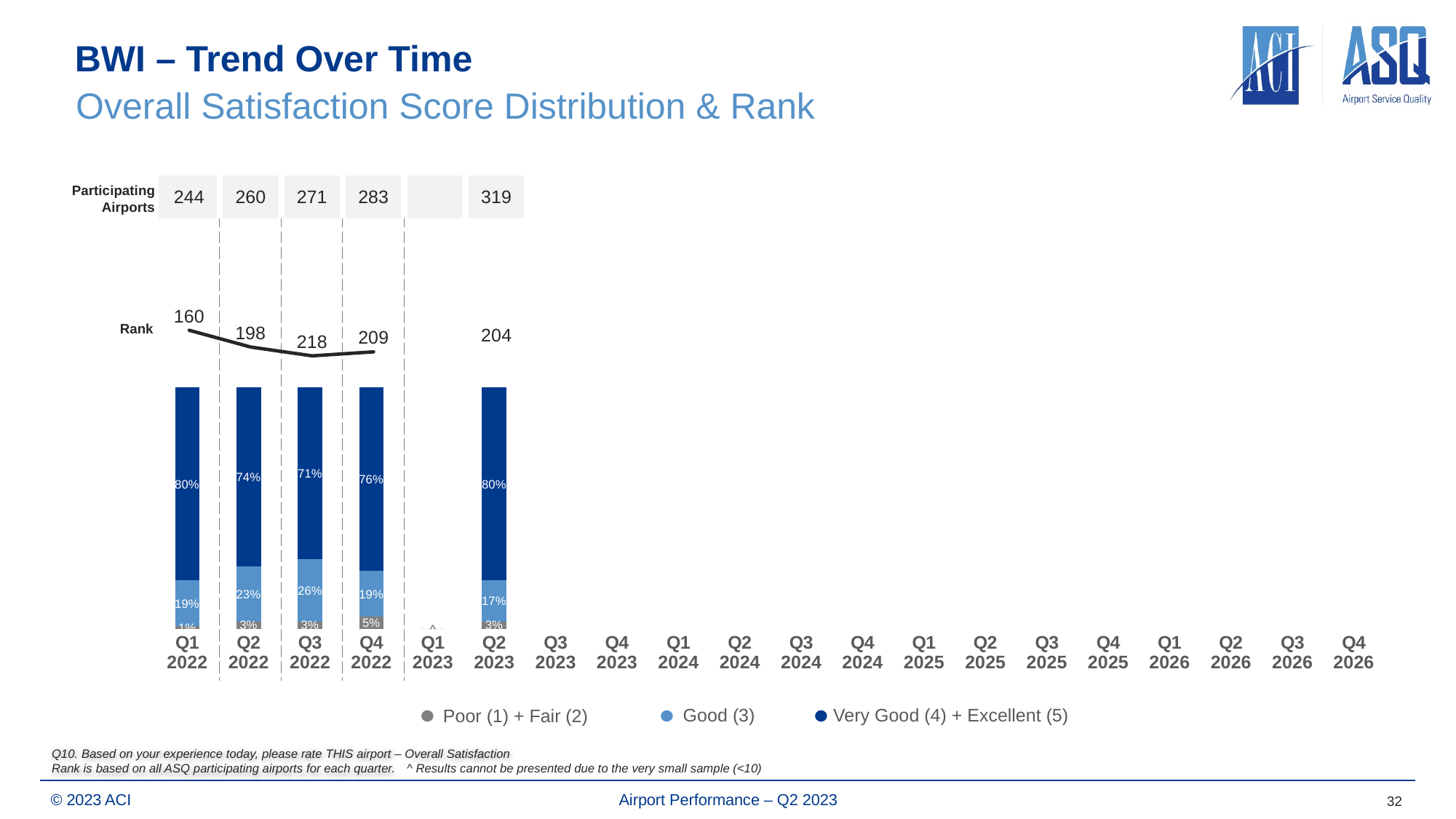
What share of respondents rated BWI Good (3) in Q4 2022? 19% Which quarter had a larger Poor (1) + Fair (2) share, Q4 2022 or Q2 2023? Q4 2022 Why is no bar shown for Q1 2023? Results cannot be presented due to the very small sample (<10) What was BWI's rank in Q3 2022? 218 How many quarters have a stacked bar with data shown? 5 In which quarter was the Good (3) share the highest? Q3 2022 How many participating airports were there in Q2 2023? 319 What is the difference between the Very Good (4) + Excellent (5) share in Q1 2022 and Q3 2022? 9 percentage points In which quarter was the Poor (1) + Fair (2) share the lowest? Q1 2022 How many series does the legend list? 3 What percentage of respondents rated BWI Very Good (4) + Excellent (5) in Q2 2023? 80% What type of chart is used to show the satisfaction score distribution? Stacked bar chart